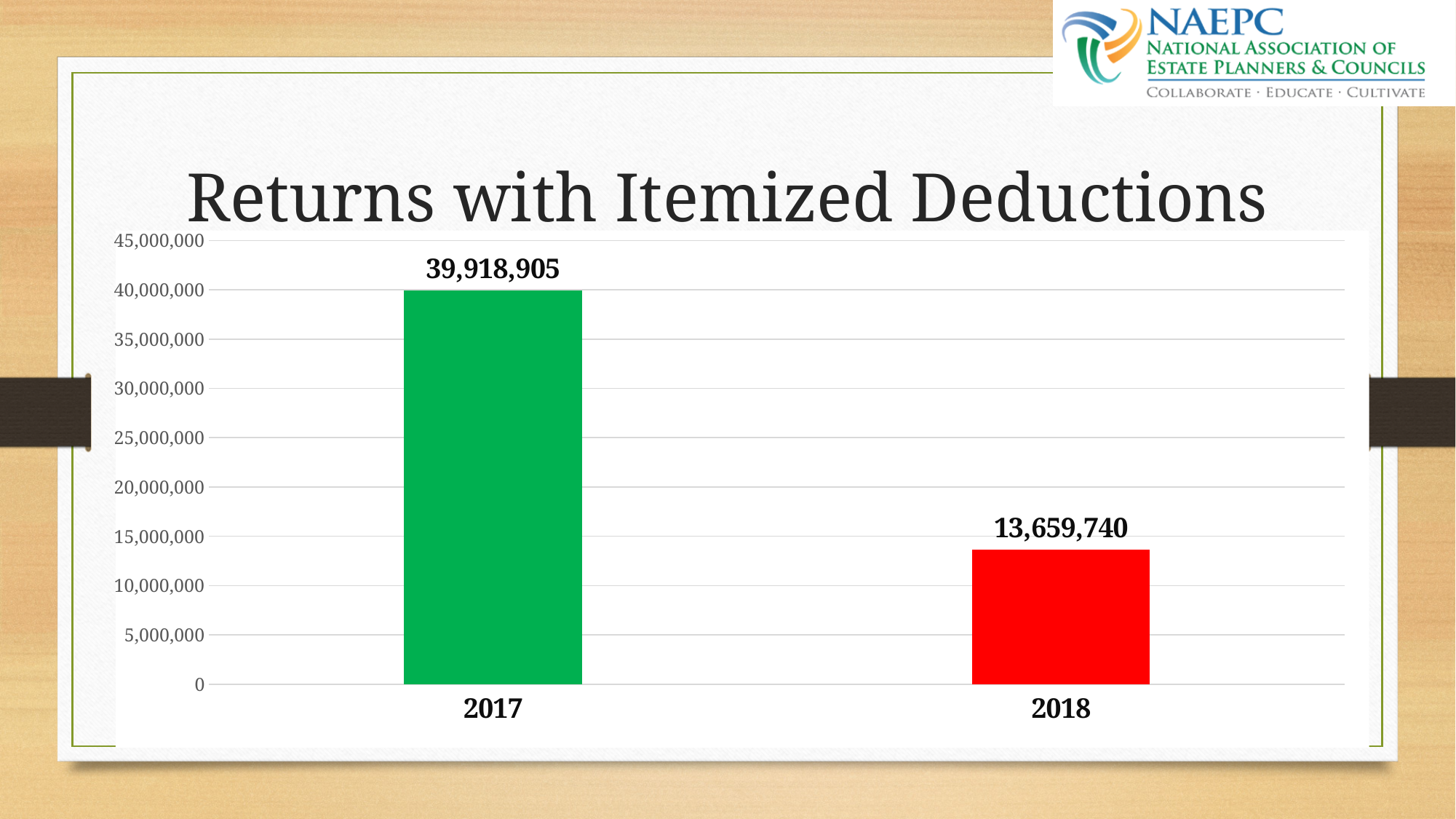
Which year has the lowest value? 2018 How many categories are shown on the x axis? 2 Do the values rise or fall from 2017 to 2018? fall What kind of chart is shown on the slide? bar chart What is the difference between the values for 2017 and 2018? 26,259,165 Which is larger, the value for 2017 or the value for 2018? 2017 What is the value for 2018? 13,659,740 What is the value for 2017? 39,918,905 Is the value for 2017 greater or less than 35,000,000? greater Is the value for 2018 greater or less than 15,000,000? less What is the title of the chart? Returns with Itemized Deductions Which year has the highest value? 2017